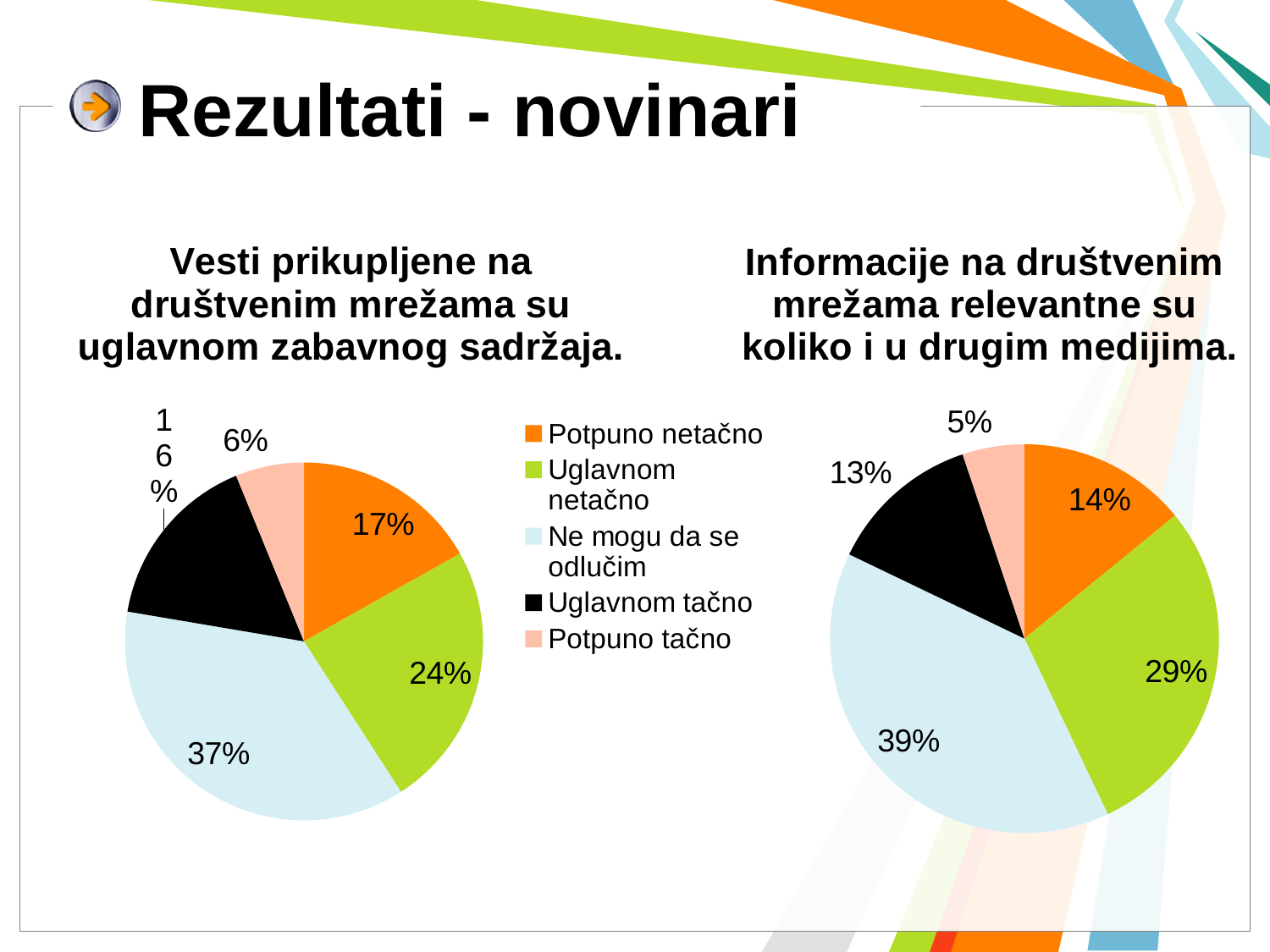
How many slices does the right chart ("Informacije na društvenim mrežama relevantne su koliko i u drugim medijima.") have? 5 In the right chart ("Informacije na društvenim mrežama relevantne su koliko i u drugim medijima."), what share is "Uglavnom netačno"? 29% What type of chart is used on this slide? Pie chart In the left chart ("Vesti prikupljene na društvenim mrežama su uglavnom zabavnog sadržaja."), what share is "Potpuno tačno"? 6% In the right chart ("Informacije na društvenim mrežama relevantne su koliko i u drugim medijima."), what is the difference between "Ne mogu da se odlučim" and "Potpuno netačno"? 25% Which is larger in the left chart ("Vesti prikupljene na društvenim mrežama su uglavnom zabavnog sadržaja."): "Uglavnom tačno" or "Potpuno netačno"? Potpuno netačno In the left chart ("Vesti prikupljene na društvenim mrežama su uglavnom zabavnog sadržaja."), which category has the largest slice? Ne mogu da se odlučim In the right chart ("Informacije na društvenim mrežama relevantne su koliko i u drugim medijima."), which category has the smallest slice? Potpuno tačno In the left chart ("Vesti prikupljene na društvenim mrežama su uglavnom zabavnog sadržaja."), what share is "Ne mogu da se odlučim"? 37% What colour represents "Uglavnom tačno" in the legend? Black In the left chart ("Vesti prikupljene na društvenim mrežama su uglavnom zabavnog sadržaja."), what is the difference between "Uglavnom netačno" and "Potpuno netačno"? 7% In the right chart ("Informacije na društvenim mrežama relevantne su koliko i u drugim medijima."), what share is "Uglavnom tačno"? 13%